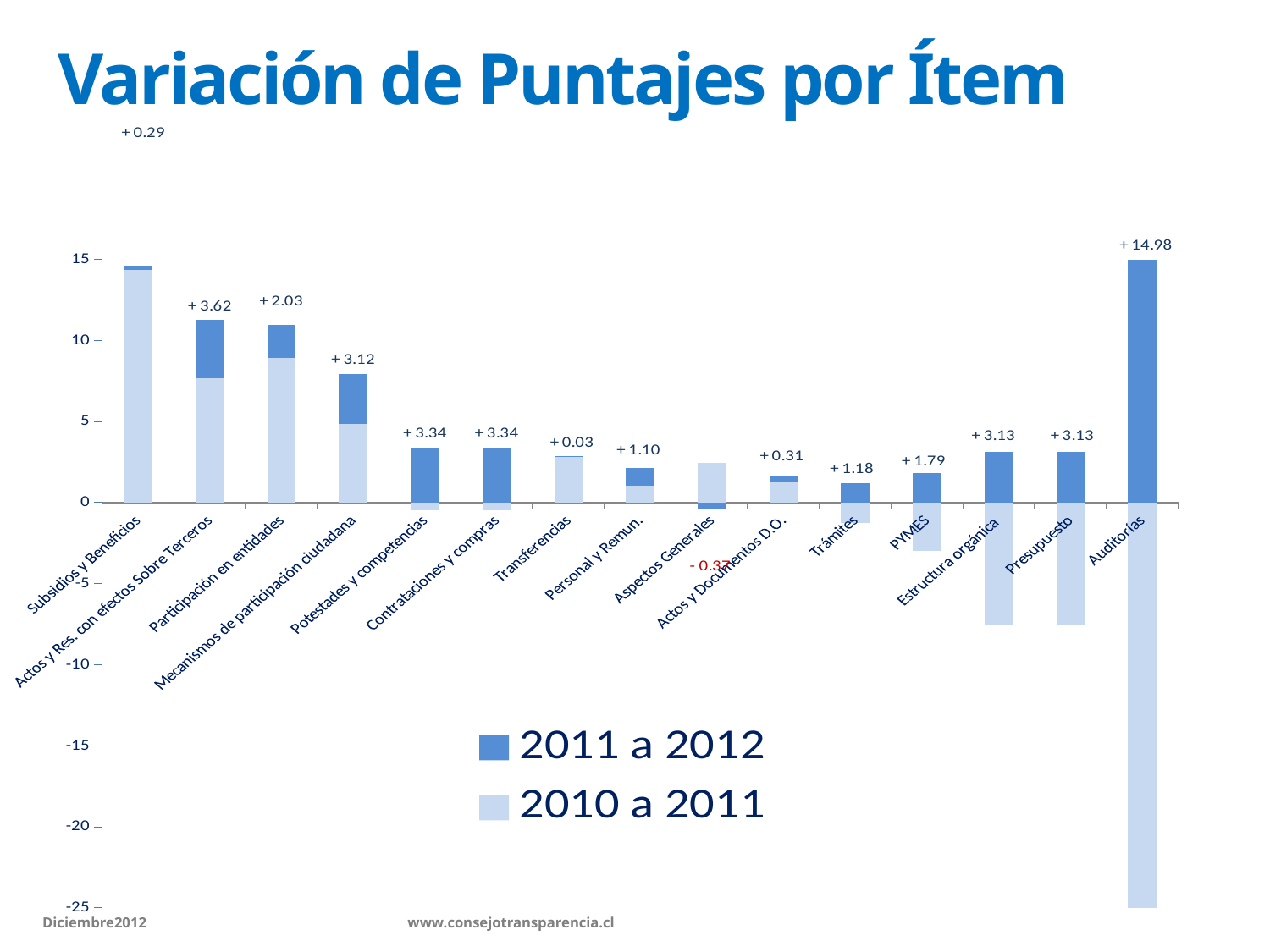
What kind of chart is shown on the slide? Bar chart Is the 2010 a 2011 value for Subsidios y Beneficios greater or less than 10? greater How many categories are shown on the x axis? 15 Which has the larger 2011 a 2012 value, Trámites or PYMES? PYMES Which category has the highest 2011 a 2012 value? Auditorías Which category has the lowest 2011 a 2012 value? Aspectos Generales What is the difference between the 2011 a 2012 values for Actos y Res. con efectos Sobre Terceros and Participación en entidades? 1.59 What is the 2011 a 2012 value for Auditorías? + 14.98 What is the 2011 a 2012 value for Mecanismos de participación ciudadana? + 3.12 What is the 2011 a 2012 value for Transferencias? + 0.03 Is the 2010 a 2011 value for Auditorías greater or less than -20? less How many series does the legend list? 2